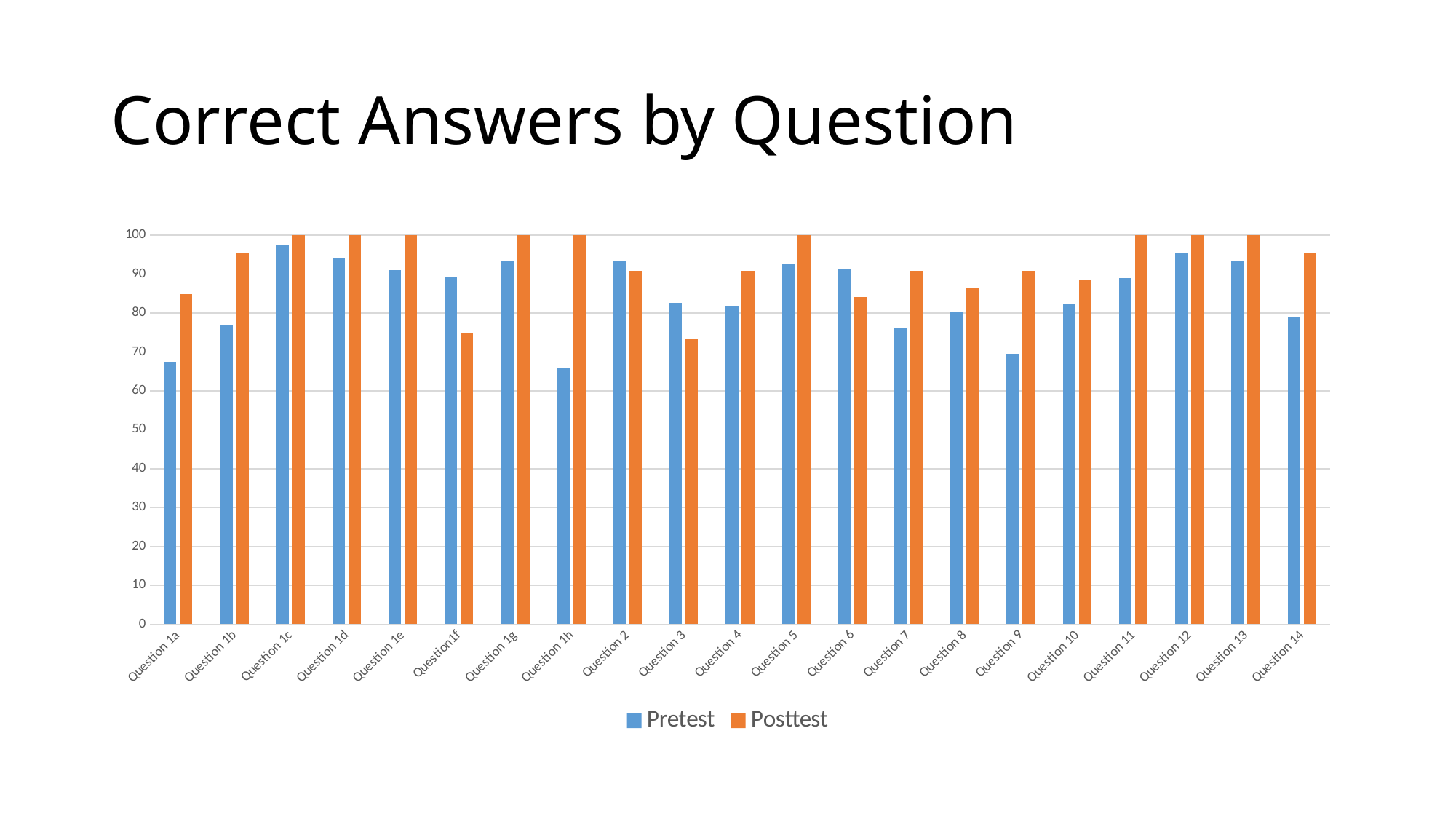
What is the Posttest value for Question 11? 100 What type of chart is shown on the slide? bar chart For Question 1h, which is larger, the Pretest or the Posttest value? Posttest Is the Posttest value for Question 1f greater or less than 80? less How many question categories are shown on the x axis? 21 For Question 1f, which is larger, the Pretest or the Posttest value? Pretest What is the Posttest value for Question 1c? 100 What is the Posttest value for Question 5? 100 What is the title of the chart? Correct Answers by Question Is the Pretest value for Question 1h greater or less than 70? less How many series does the legend list? 2 Is the Pretest value for Question 1c greater or less than 90? greater